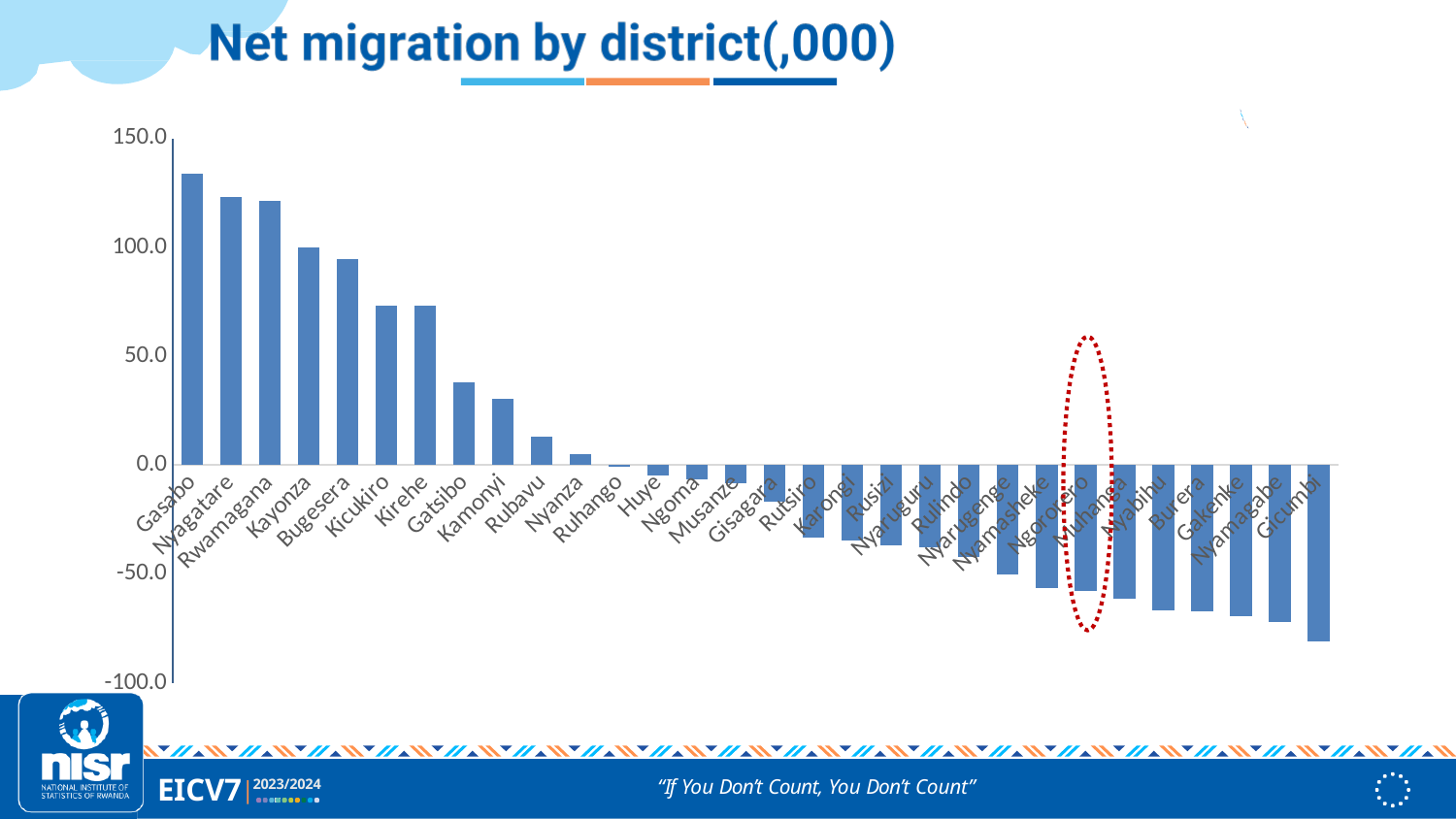
How many districts are plotted in the chart? 30 Is the value for Gicumbi greater or less than -50.0? less Is the value for Gatsibo greater or less than 50.0? less Which has the larger net migration, Gasabo or Nyagatare? Gasabo Is the value for Bugesera greater or less than 100.0? less Do the values rise or fall moving from left to right along the x axis? fall What is the title of the chart? Net migration by district(,000) Which district has the lowest net migration? Gicumbi What kind of chart is shown on the slide? bar chart Which has the larger net migration, Rubavu or Nyanza? Rubavu Which district has the highest net migration? Gasabo